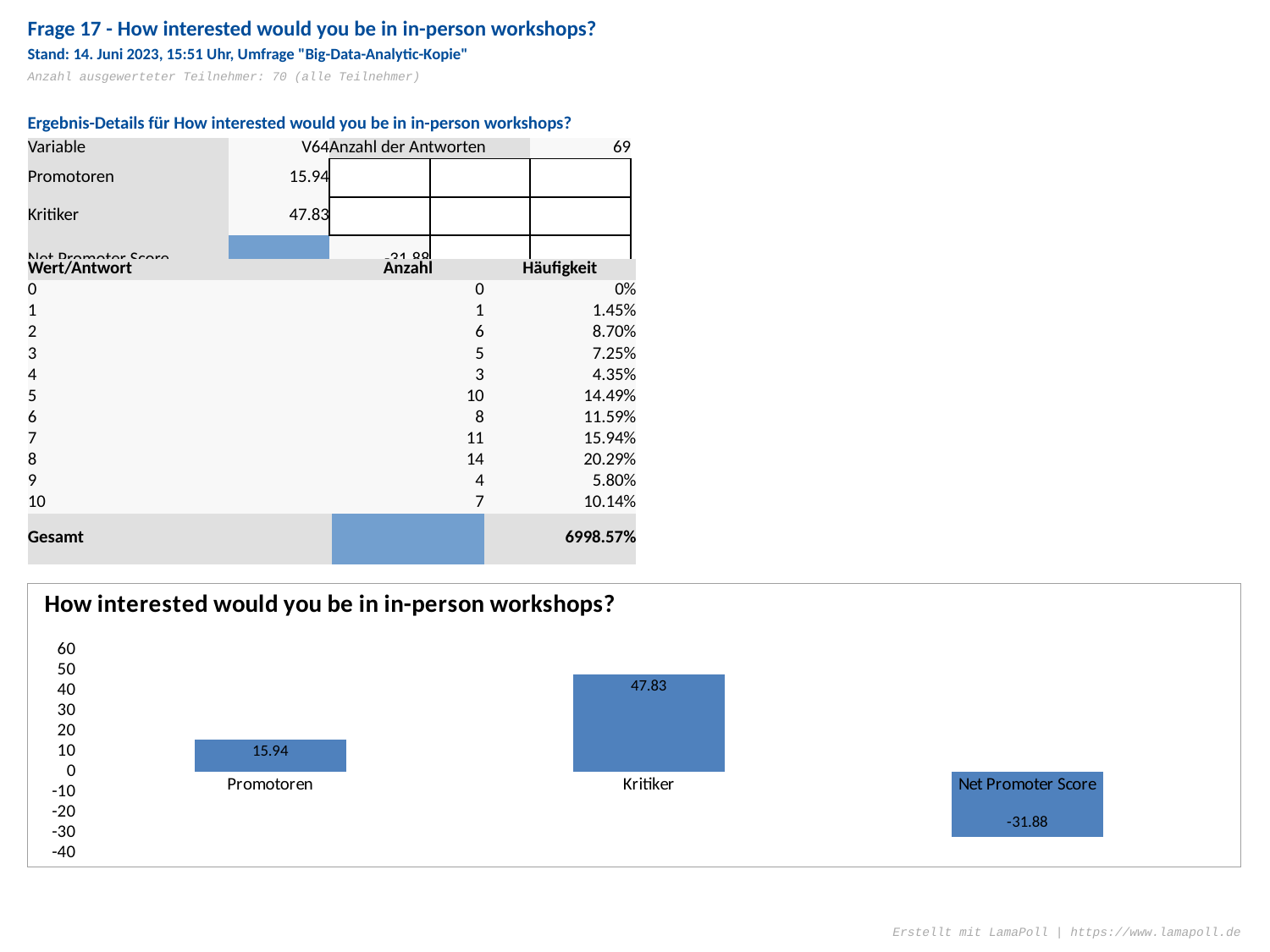
What is the value for Net Promoter Score in the chart? -31.88 What kind of chart is shown on the slide? bar chart Is the value for Net Promoter Score greater or less than 0? less Is the value for Kritiker greater or less than 40? greater What is the difference between the values for Kritiker and Promotoren? 31.89 Which is larger, the value for Promotoren or the value for Kritiker? Kritiker How many categories are shown in the chart? 3 Which category has the lowest value in the chart? Net Promoter Score Which category has the highest value in the chart? Kritiker What is the value for Kritiker in the chart? 47.83 What is the title of the chart? How interested would you be in in-person workshops? What is the value for Promotoren in the chart? 15.94